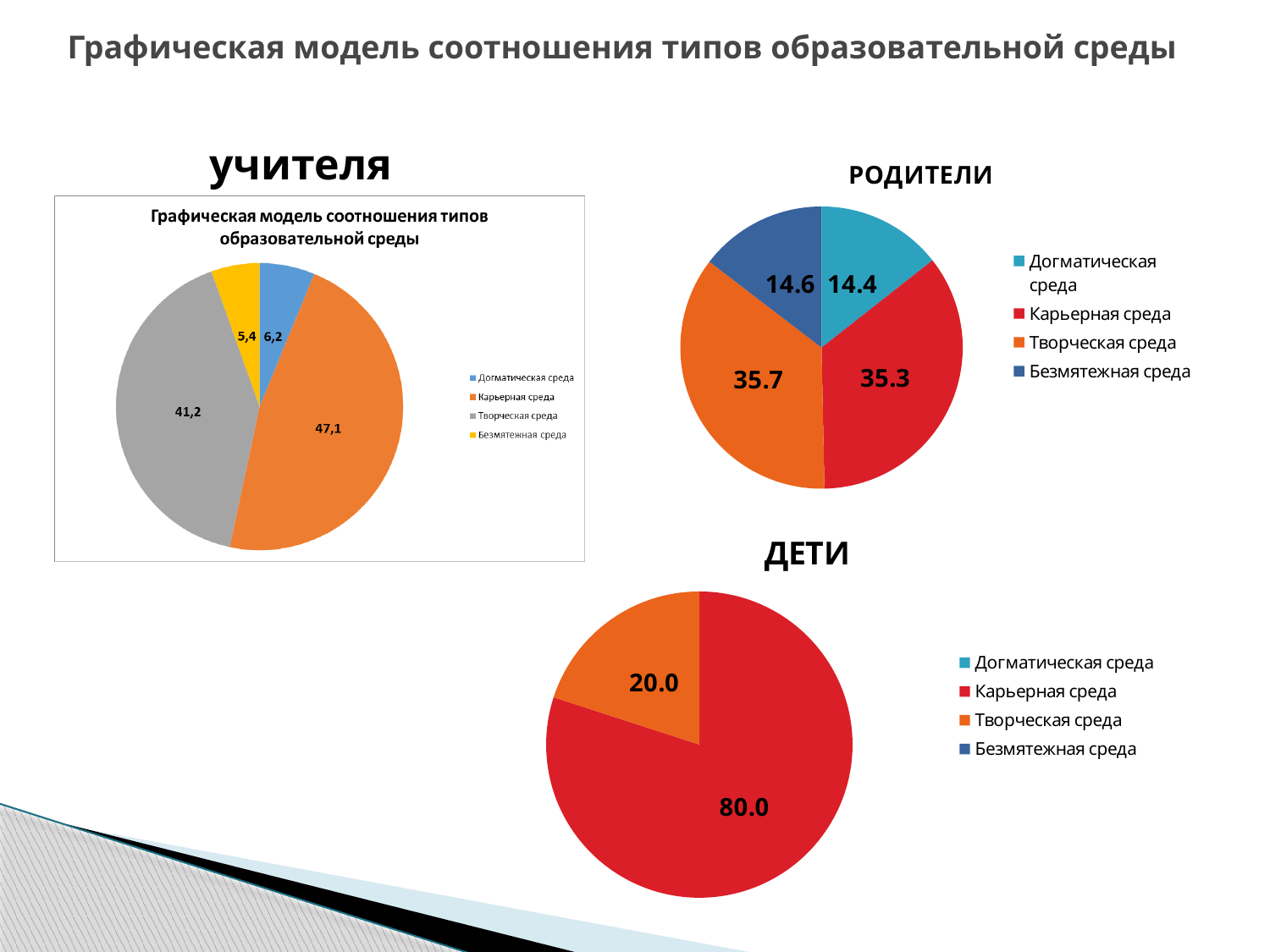
What type of chart is the РОДИТЕЛИ chart? Pie chart In the учителя chart, what is the value for Творческая среда? 41,2 In the ДЕТИ chart, what is the value for Карьерная среда? 80.0 In the РОДИТЕЛИ chart, what is the value for Безмятежная среда? 14.6 In the ДЕТИ chart, which is larger, Карьерная среда or Творческая среда? Карьерная среда In the РОДИТЕЛИ chart, what is the value for Догматическая среда? 14.4 In the учителя chart, what is the difference between Карьерная среда and Творческая среда? 5,9 How many slices does the ДЕТИ pie chart have? 2 In the учителя chart, which category has the largest slice? Карьерная среда In the учителя chart, what is the value for Карьерная среда? 47,1 In the РОДИТЕЛИ chart, what is the difference between Творческая среда and Карьерная среда? 0.4 In the учителя chart, which category has the smallest slice? Безмятежная среда